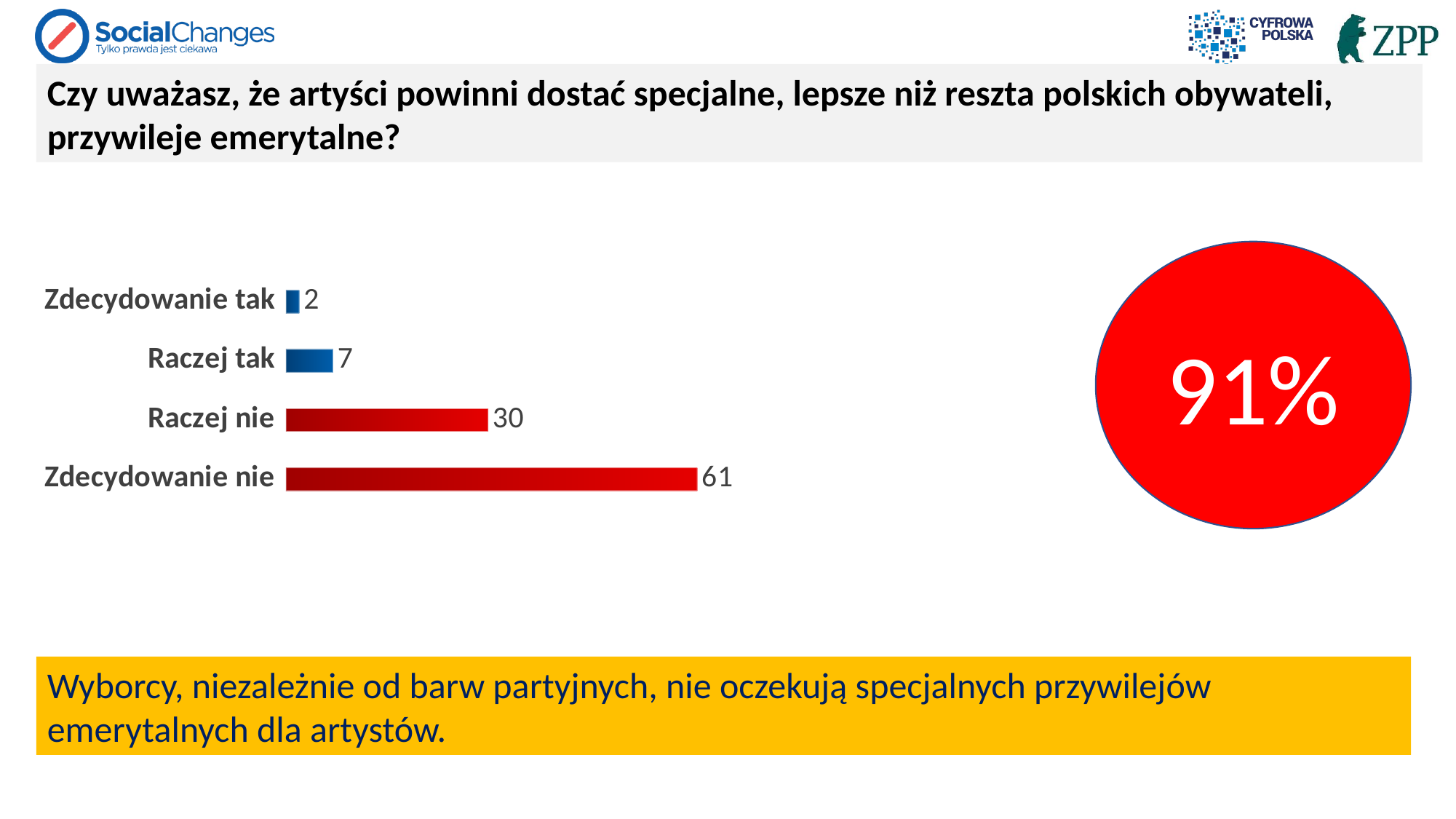
What is the value for "Zdecydowanie nie"? 61 Which is larger, the value for "Raczej nie" or the value for "Raczej tak"? Raczej nie How many categories does the bar chart show? 4 What is the value for "Raczej nie"? 30 What is the value for "Raczej tak"? 7 What percentage is shown in the large red circle on the right of the slide? 91% Which category has the highest value? Zdecydowanie nie Which category has the lowest value? Zdecydowanie tak What is the value for "Zdecydowanie tak"? 2 What kind of chart is shown on the slide? Bar chart What is the difference between the values for "Zdecydowanie nie" and "Raczej nie"? 31 What is the difference between the values for "Raczej tak" and "Zdecydowanie tak"? 5